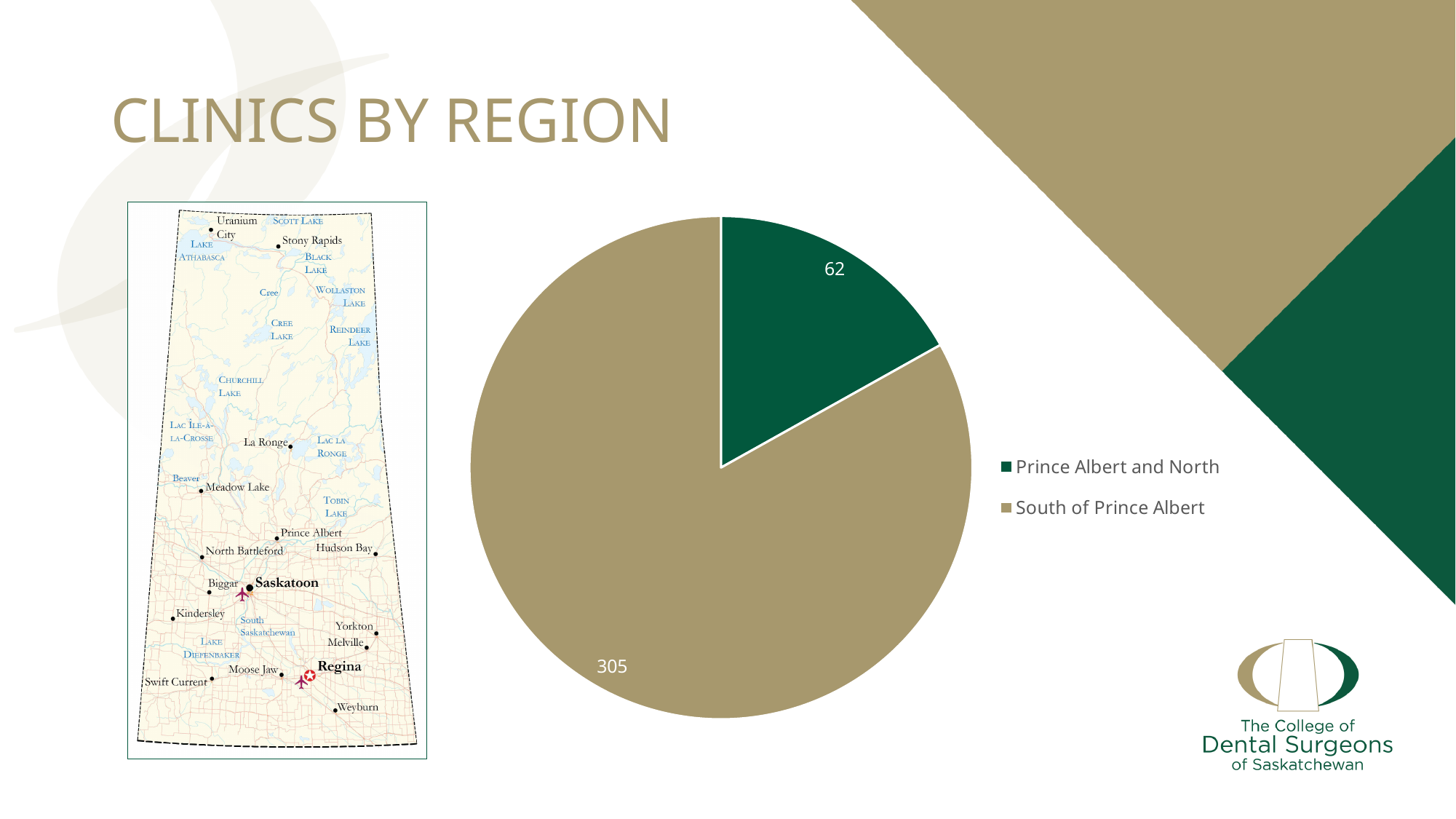
What colour is the Prince Albert and North slice in the pie chart? Green Which region has the smallest slice in the pie chart? Prince Albert and North Which region has the largest slice in the pie chart? South of Prince Albert What is the difference between the number of clinics South of Prince Albert and the number in Prince Albert and North? 243 How many slices does the pie chart have? 2 What value is shown for the Prince Albert and North slice of the pie chart? 62 What is the title of the slide containing the pie chart? CLINICS BY REGION What value is shown for the South of Prince Albert slice of the pie chart? 305 Which has more clinics: Prince Albert and North, or South of Prince Albert? South of Prince Albert What kind of chart is shown on the slide? Pie chart What is the total number of clinics across both regions in the pie chart? 367 How many entries does the legend of the pie chart list? 2